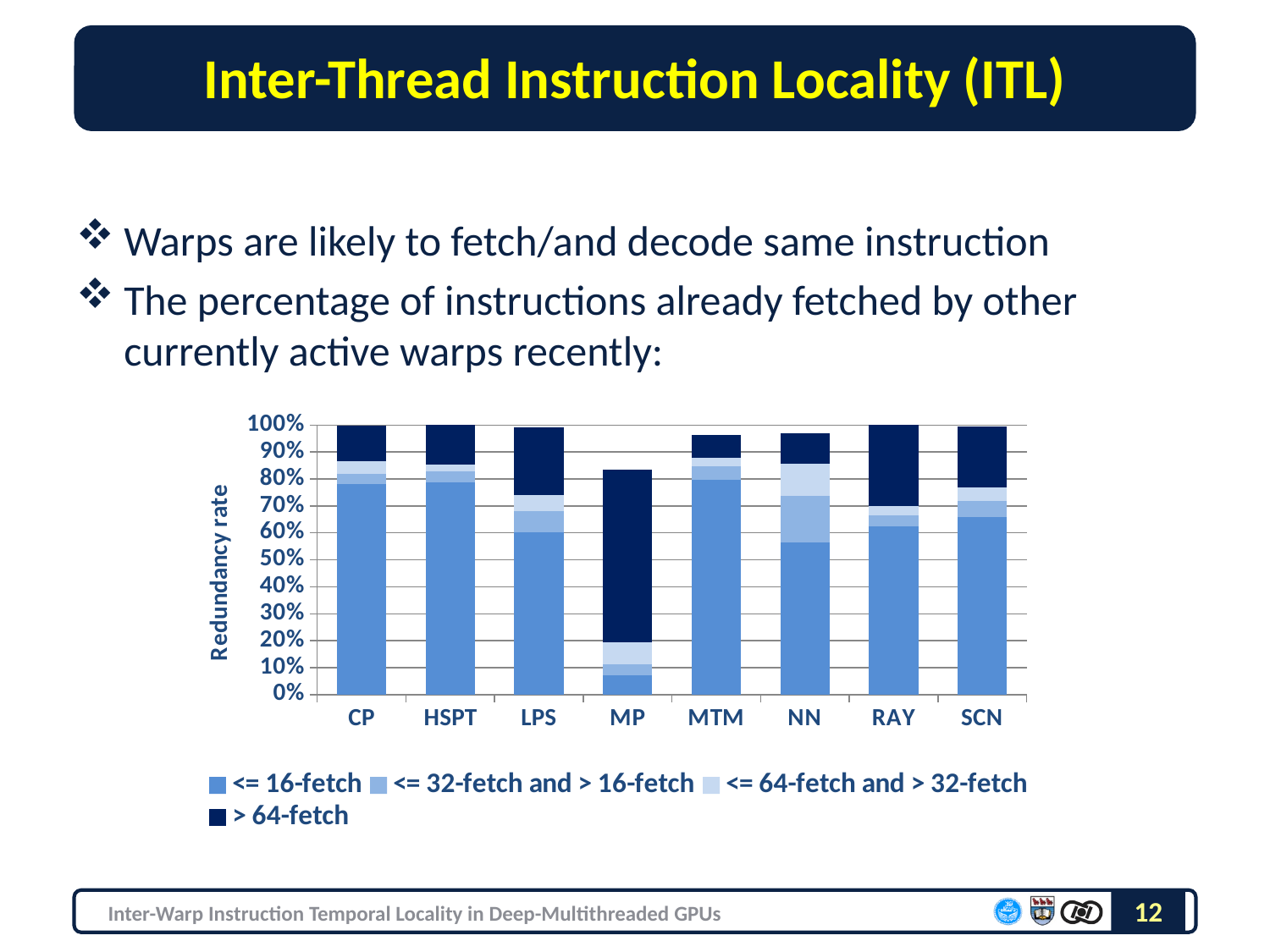
How many series does the chart's legend list? 4 Which category has the smallest <= 16-fetch segment? MP Which legend entry is drawn in the darkest colour in the chart? > 64-fetch Which category has the largest > 64-fetch segment? MP Is the <= 16-fetch value for MP greater or less than 10%? less Is the <= 16-fetch value for NN greater or less than 50%? greater Which has a larger <= 16-fetch segment, CP or MP? CP How many benchmark categories are shown on the x axis of the chart? 8 What kind of chart is shown on the slide? Stacked bar chart Is the <= 16-fetch value for CP greater or less than 70%? greater What is the label of the y axis of the chart? Redundancy rate